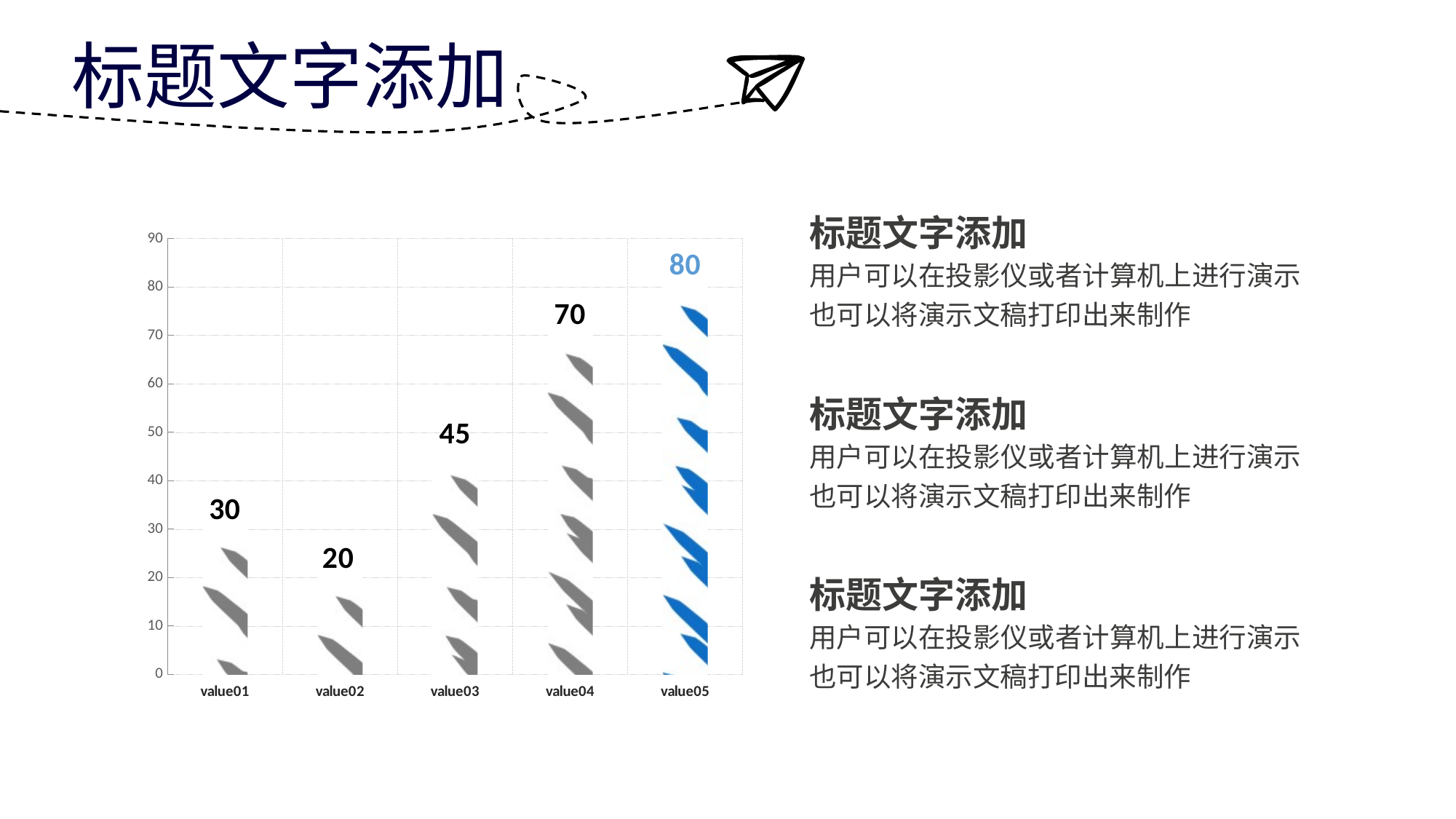
What is the value for value01? 30 How many categories are shown on the x axis? 5 Which bar is shown in blue rather than grey? value05 Which is larger, the value for value03 or the value for value01? value03 What is the value for value05? 80 Which category has the lowest value? value02 What kind of chart is shown on the slide? bar chart What is the difference between the values for value05 and value01? 50 What is the value for value03? 45 Is the value for value04 greater or less than 60? greater What is the difference between the values for value04 and value02? 50 Which category has the highest value? value05